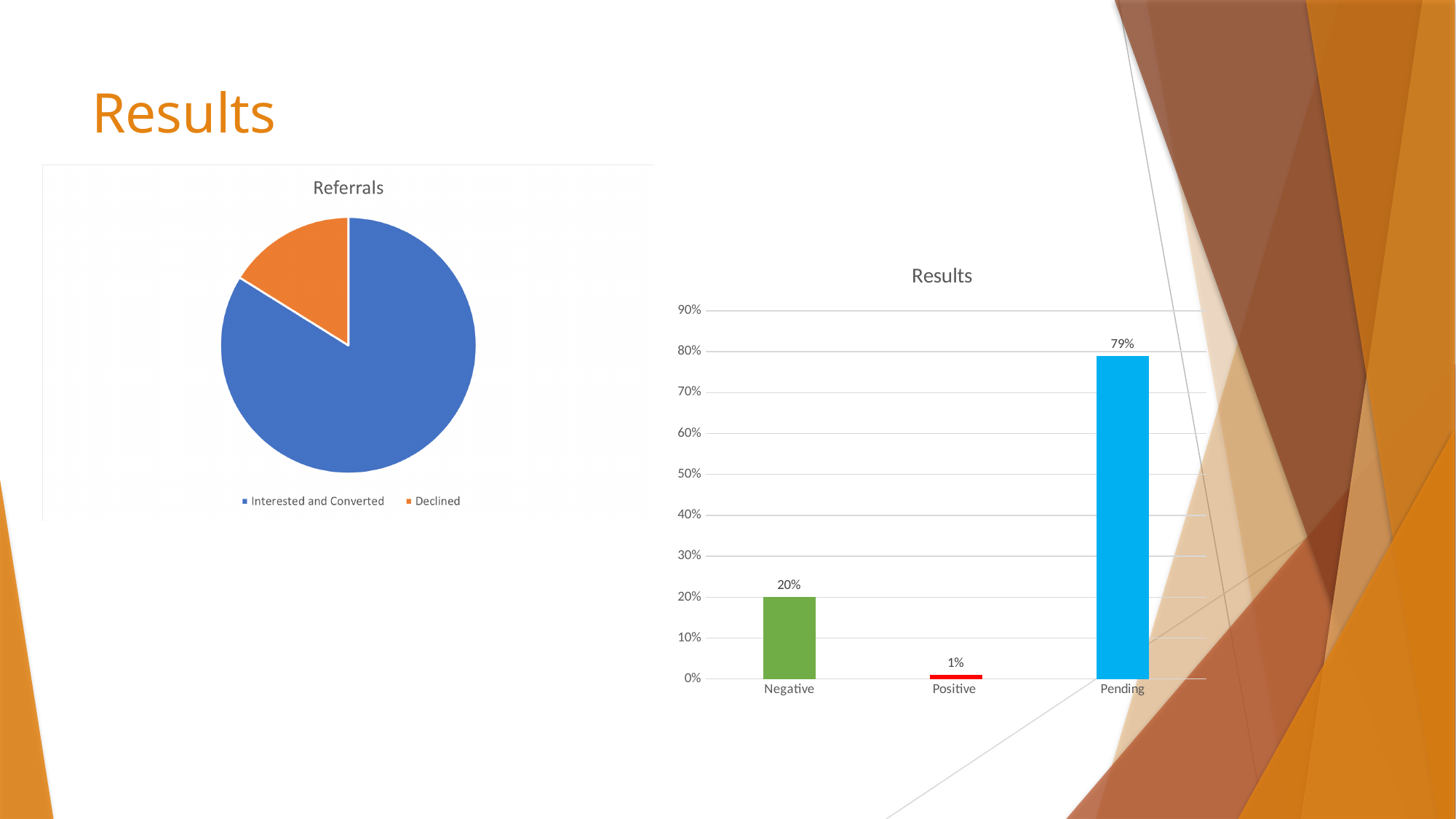
In the Results bar chart, what is the value for Negative? 20% In the Results bar chart, how many categories are shown on the x axis? 3 In the Results bar chart, what is the difference between the values for Pending and Negative? 59% In the Results bar chart, which category has the highest value? Pending What kind of chart is the Results chart on the right of the slide? Bar chart How many entries does the legend of the Referrals pie chart list? 2 In the Results bar chart, what is the value for Positive? 1% In the Referrals pie chart, which slice is larger, Interested and Converted or Declined? Interested and Converted In the Results bar chart, which is larger, the value for Negative or the value for Positive? Negative In the Results bar chart, what is the value for Pending? 79% In the Results bar chart, which category has the lowest value? Positive What kind of chart is the Referrals chart on the left of the slide? Pie chart